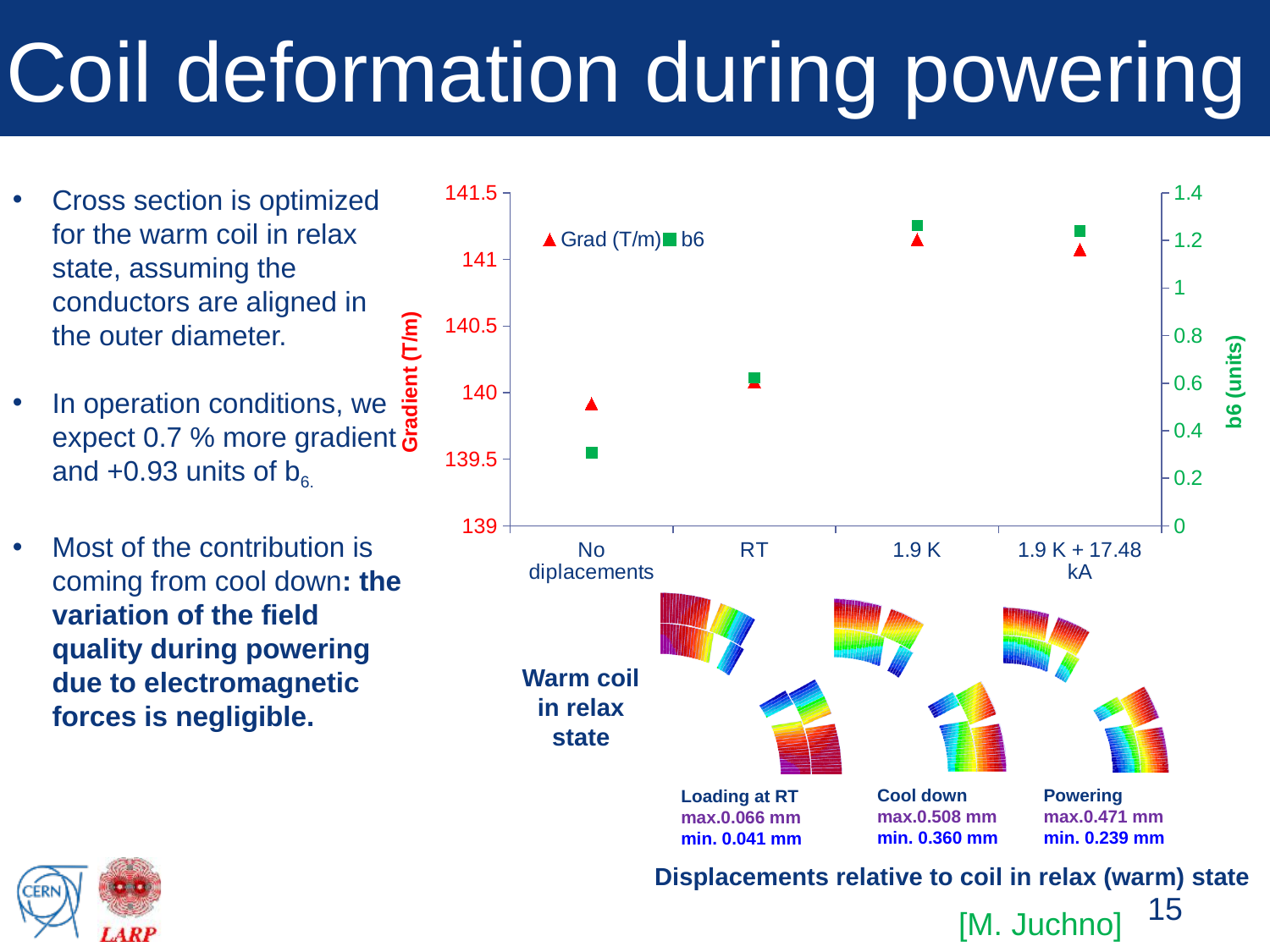
Is the Grad (T/m) value at 1.9 K greater or less than 141? greater Is the b6 value at RT greater or less than 0.8? less How many series does the chart legend list? 2 Does the Grad (T/m) value rise or fall from No diplacements to 1.9 K? rise What are the two series named in the chart legend? Grad (T/m) and b6 Which category has the lowest Grad (T/m) value? No diplacements What is the title of the left vertical axis of the chart? Gradient (T/m) Is the b6 value at 1.9 K greater or less than 1? greater How many categories are shown along the x axis of the chart? 4 Which is larger, the b6 value at No diplacements or at 1.9 K + 17.48 kA? 1.9 K + 17.48 kA Which is larger, the Grad (T/m) value at RT or at 1.9 K? 1.9 K